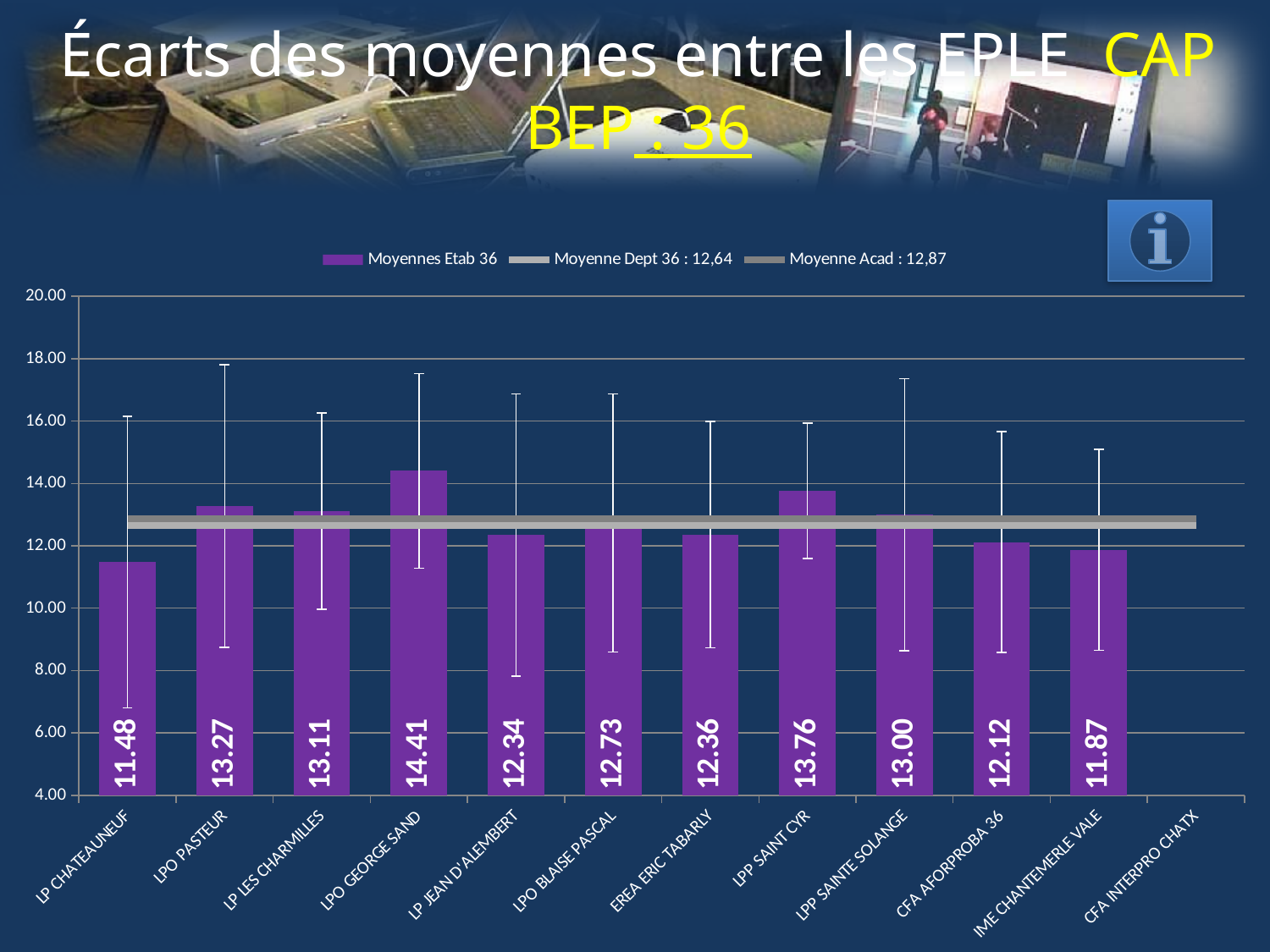
Which establishment has the highest average? LPO GEORGE SAND Which establishment has the lowest average? LP CHATEAUNEUF What is the value for LP CHATEAUNEUF? 11.48 What is the value for LPP SAINT CYR? 13.76 How many series does the legend list? 3 What is the value for IME CHANTEMERLE VALE? 11.87 What is the value for LPO GEORGE SAND? 14.41 What value does the legend give for Moyenne Dept 36? 12,64 What kind of chart is shown on the slide? Bar chart What is the difference between the values for LPO GEORGE SAND and LP CHATEAUNEUF? 2.93 Which is larger, the value for LPO PASTEUR or the value for LP LES CHARMILLES? LPO PASTEUR What value does the legend give for Moyenne Acad? 12,87